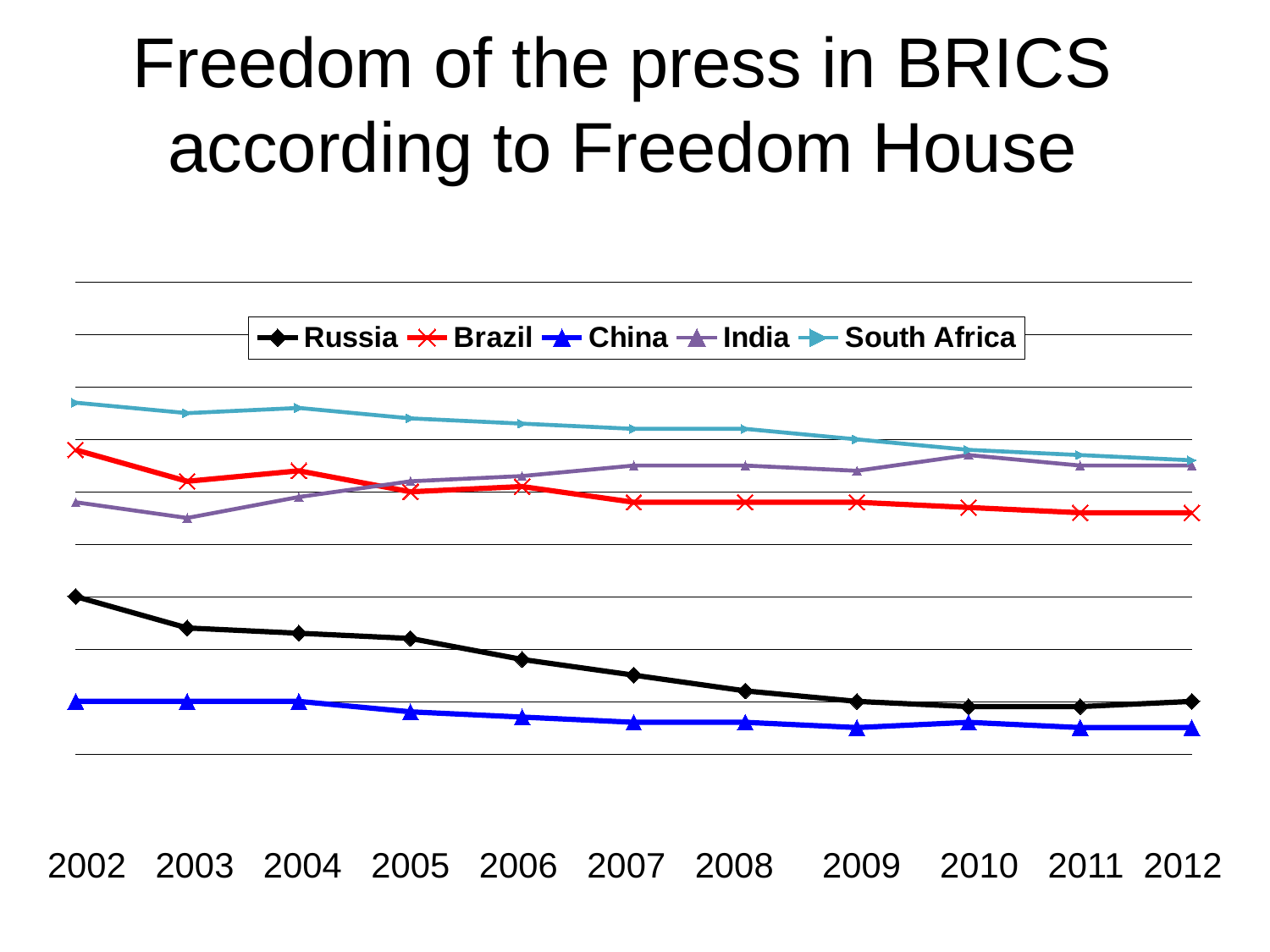
How many series does the legend list? 5 Which country has the highest value in 2002? South Africa What is the title of the chart? Freedom of the press in BRICS according to Freedom House What kind of chart is shown on the slide? line chart Which country has the lowest value in 2012? China How many years are shown along the x axis? 11 In 2012, which is higher, Russia or China? Russia Which country has the lowest value in 2002? China Does the Russia line rise or fall from 2002 to 2012? fall Does the South Africa line rise or fall from 2002 to 2012? fall In 2012, which is higher, India or Brazil? India In 2003, which is higher, Brazil or India? Brazil